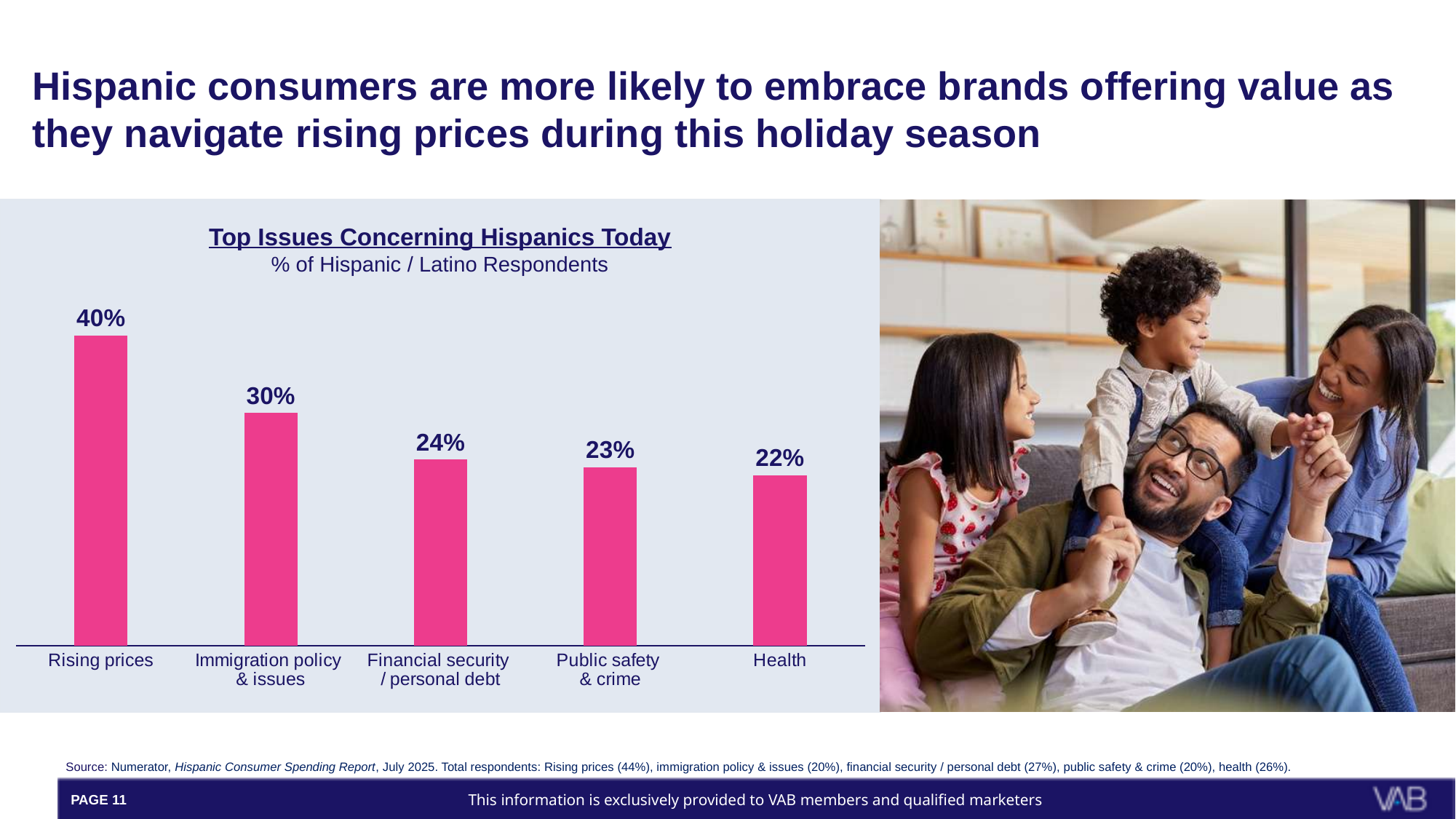
What percentage of Hispanic / Latino respondents cited Rising prices as a top issue? 40% What kind of chart is shown on the slide? Bar chart Which is larger, the value for Public safety & crime or the value for Immigration policy & issues? Immigration policy & issues Which issue has the highest percentage of respondents? Rising prices What is the difference in percentage points between Rising prices and Immigration policy & issues? 10 percentage points What is the difference between Financial security / personal debt and Health? 2 percentage points Which issue has the lowest percentage of respondents? Health What is the value for Financial security / personal debt? 24% What is the value for Immigration policy & issues? 30% How many issues are shown in the chart? 5 What is the value for Health? 22% What is the title of the chart? Top Issues Concerning Hispanics Today